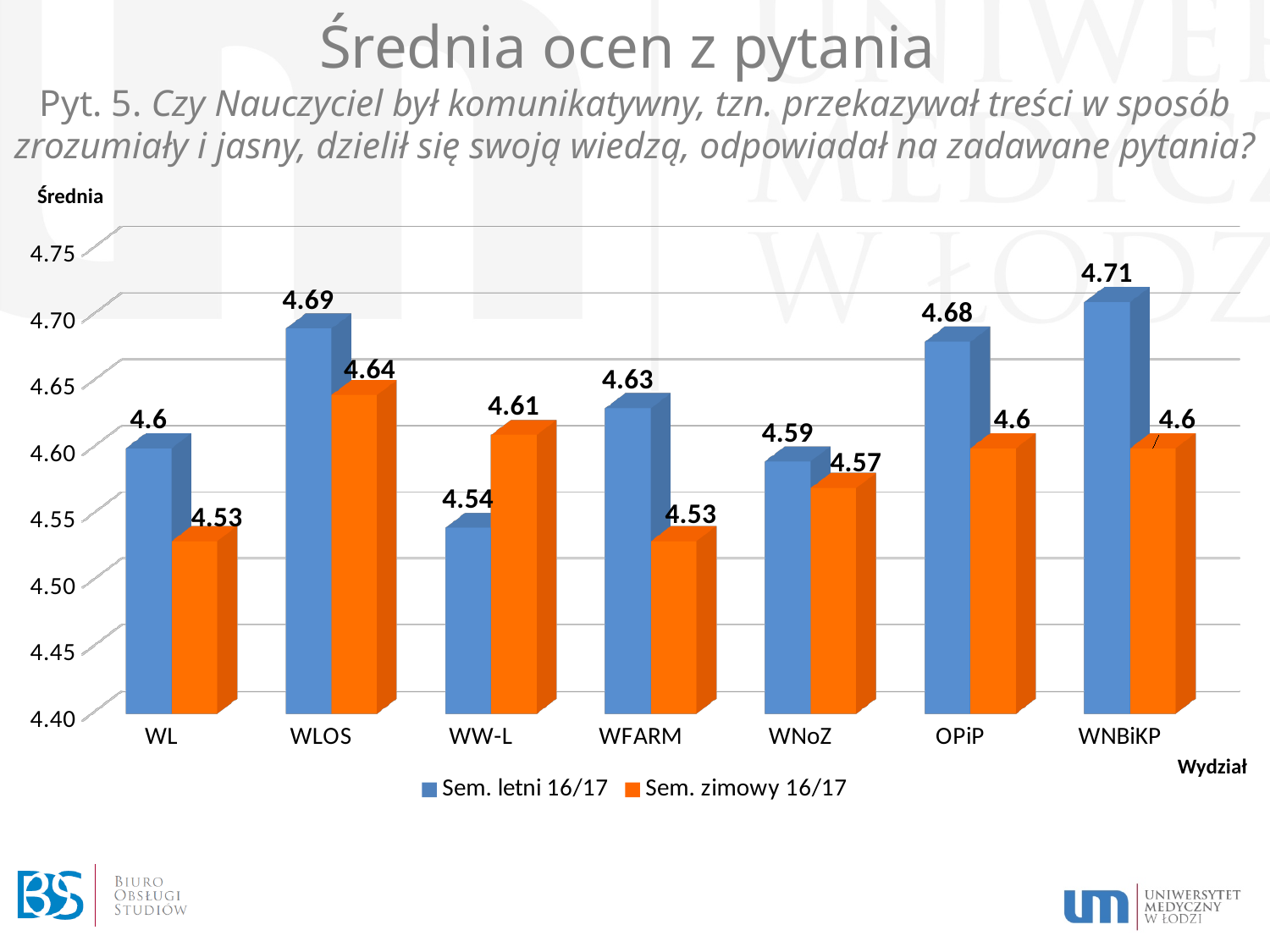
What is the value for WFARM in the Sem. zimowy 16/17 series? 4.53 How many series does the legend list? 2 What kind of chart is shown on the slide? Bar chart What is the value for WW-L in the Sem. zimowy 16/17 series? 4.61 Which category has the lowest value in the Sem. letni 16/17 series? WW-L For WW-L, which series has the larger value: Sem. letni 16/17 or Sem. zimowy 16/17? Sem. zimowy 16/17 How many categories (faculties) are shown on the x axis? 7 Which category has the highest value in the Sem. zimowy 16/17 series? WLOS What is the value for WLOS in the Sem. letni 16/17 series? 4.69 What is the label of the y axis? Średnia Which category has the highest value in the Sem. letni 16/17 series? WNBiKP What is the difference between the Sem. letni 16/17 and Sem. zimowy 16/17 values for WFARM? 0.1